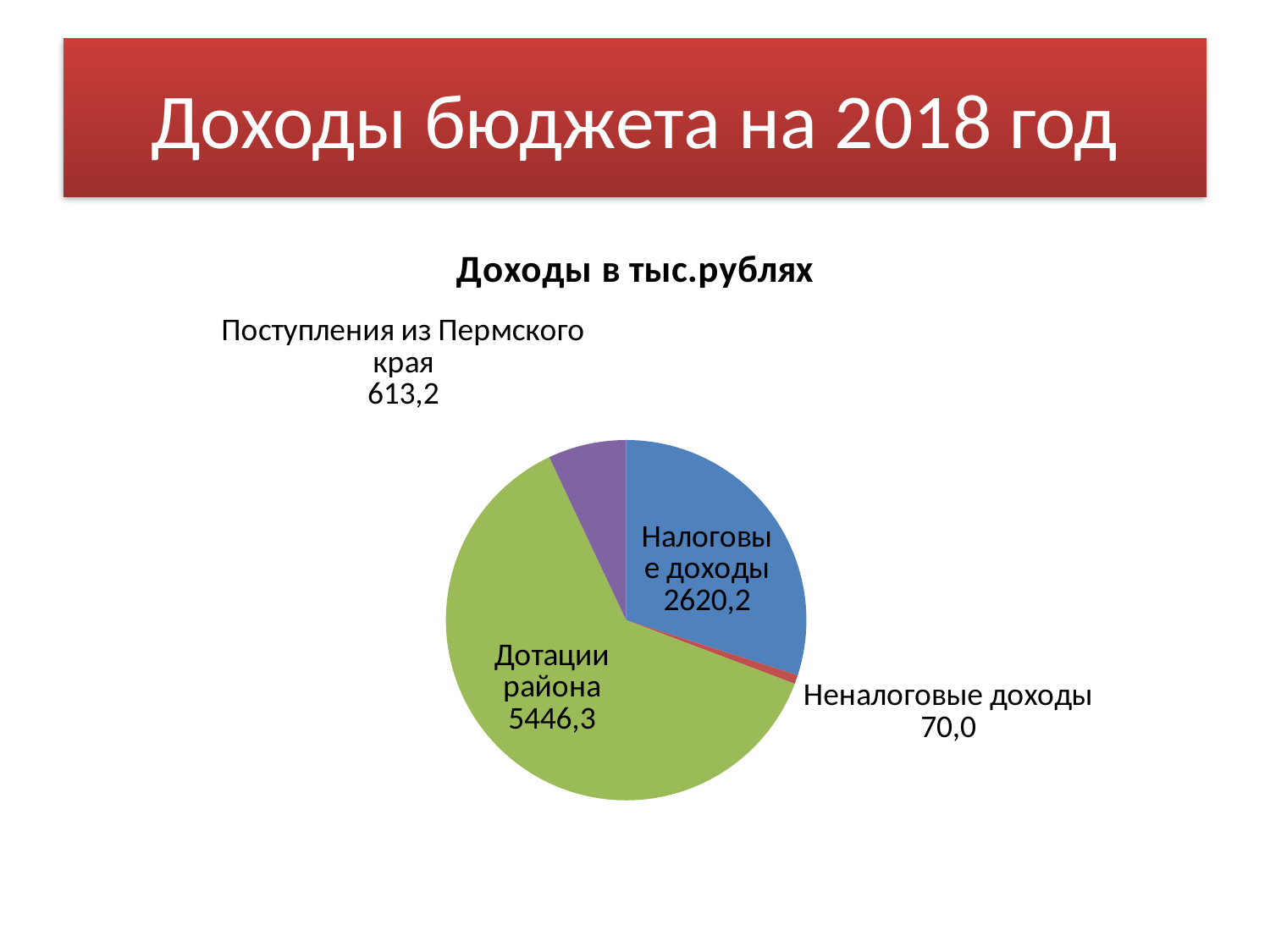
What kind of chart is shown on the slide? Pie chart Which is larger, Поступления из Пермского края or Неналоговые доходы? Поступления из Пермского края What share of the total does Дотации района represent? 62% Which category has the largest slice of the pie? Дотации района What is the value for Поступления из Пермского края? 613,2 Which category has the smallest slice of the pie? Неналоговые доходы What is the title of the chart? Доходы в тыс.рублях What is the value for Налоговые доходы? 2620,2 What is the difference between Дотации района and Налоговые доходы? 2826,1 What is the value for Дотации района? 5446,3 What is the value for Неналоговые доходы? 70,0 How many slices does the pie chart have? 4